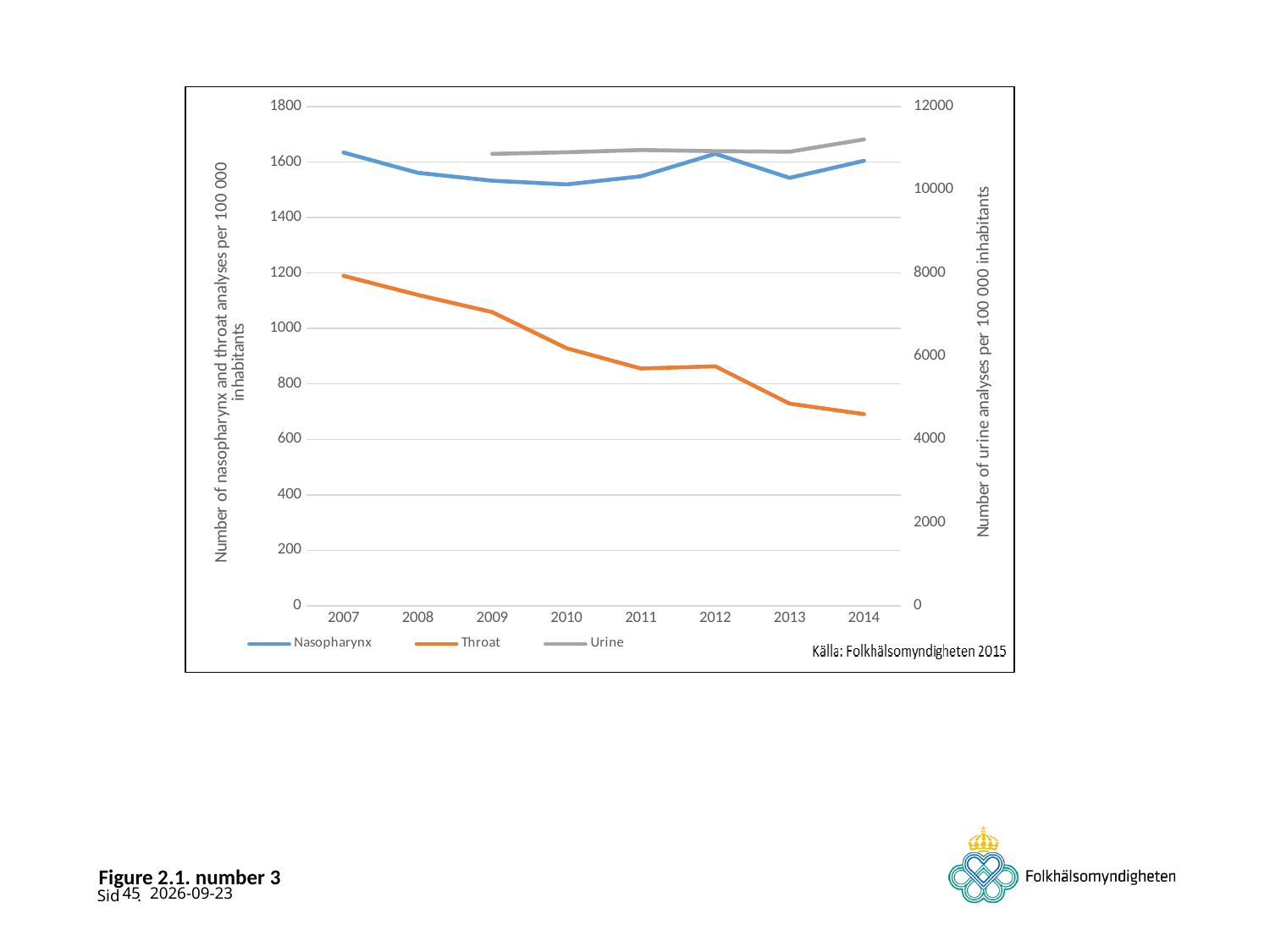
Does the Throat series rise or fall from 2007 to 2014? fall How many years are shown on the x axis? 8 What is the label of the right-hand vertical axis? Number of urine analyses per 100 000 inhabitants Is the Urine value for 2014, read on the right axis, greater or less than 10000? greater In 2007, which is larger: the Nasopharynx value or the Throat value? Nasopharynx In which year is the Throat value highest? 2007 Is the Nasopharynx value for 2010 greater or less than 1400? greater Is the Throat value for 2007 greater or less than 1000? greater In which year is the Throat value lowest? 2014 How many series does the legend list? 3 What kind of chart is shown on the slide? line chart